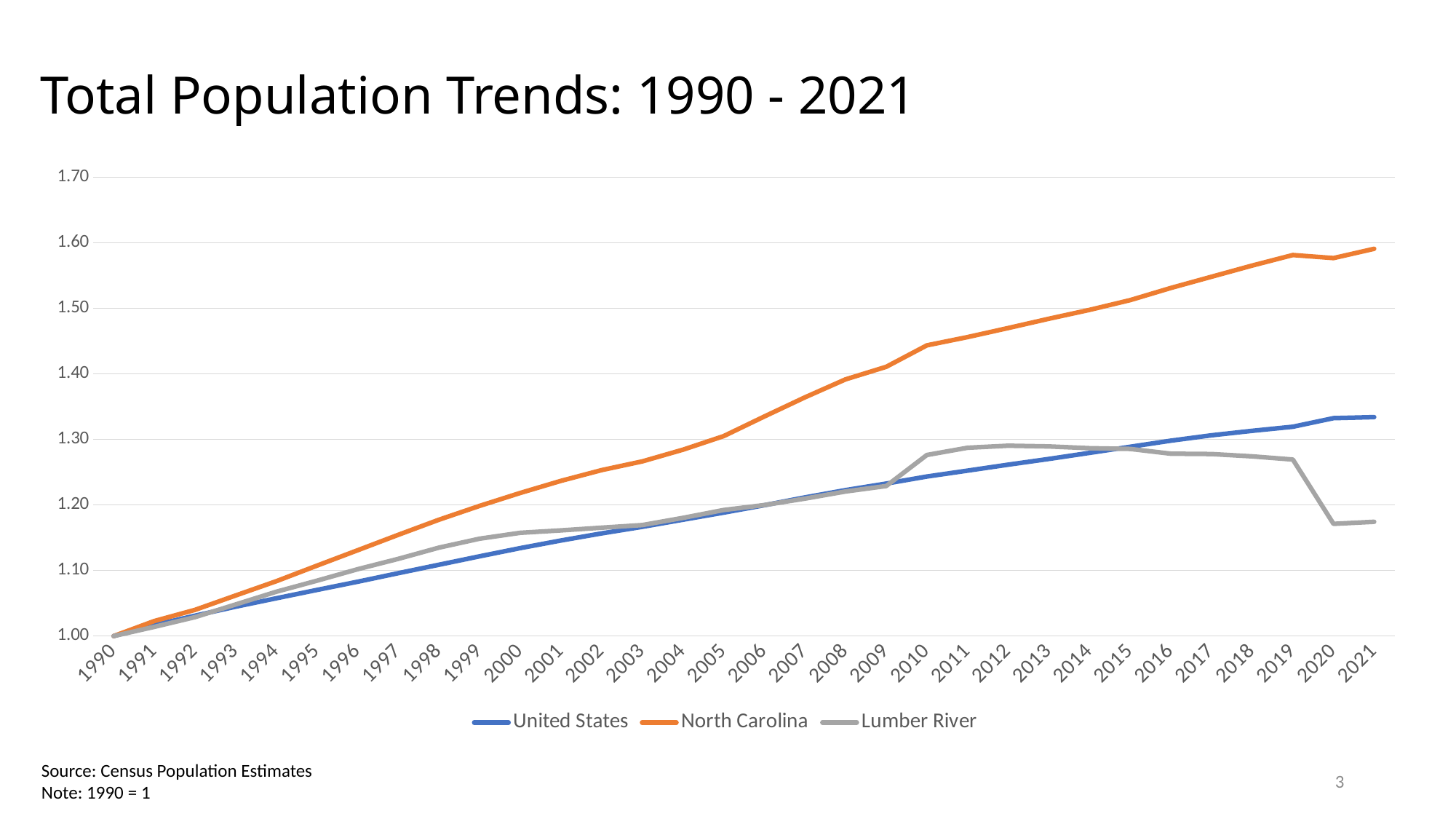
How many series does the legend list? 3 What is the title of the chart? Total Population Trends: 1990 - 2021 Does the North Carolina line generally rise or fall from 1990 to 2021? Rise Is the value for Lumber River in 2021 greater or less than 1.20? less Is the value for United States in 2021 greater or less than 1.30? greater Which series has the highest value in 2021? North Carolina What kind of chart is shown on the slide? Line chart How many years are plotted along the x axis? 32 Which series has the lowest value in 2021? Lumber River What is the value for United States in 1990? 1.00 Is the value for North Carolina in 2021 greater or less than 1.50? greater Which is larger in 2010, the value for Lumber River or the value for United States? Lumber River